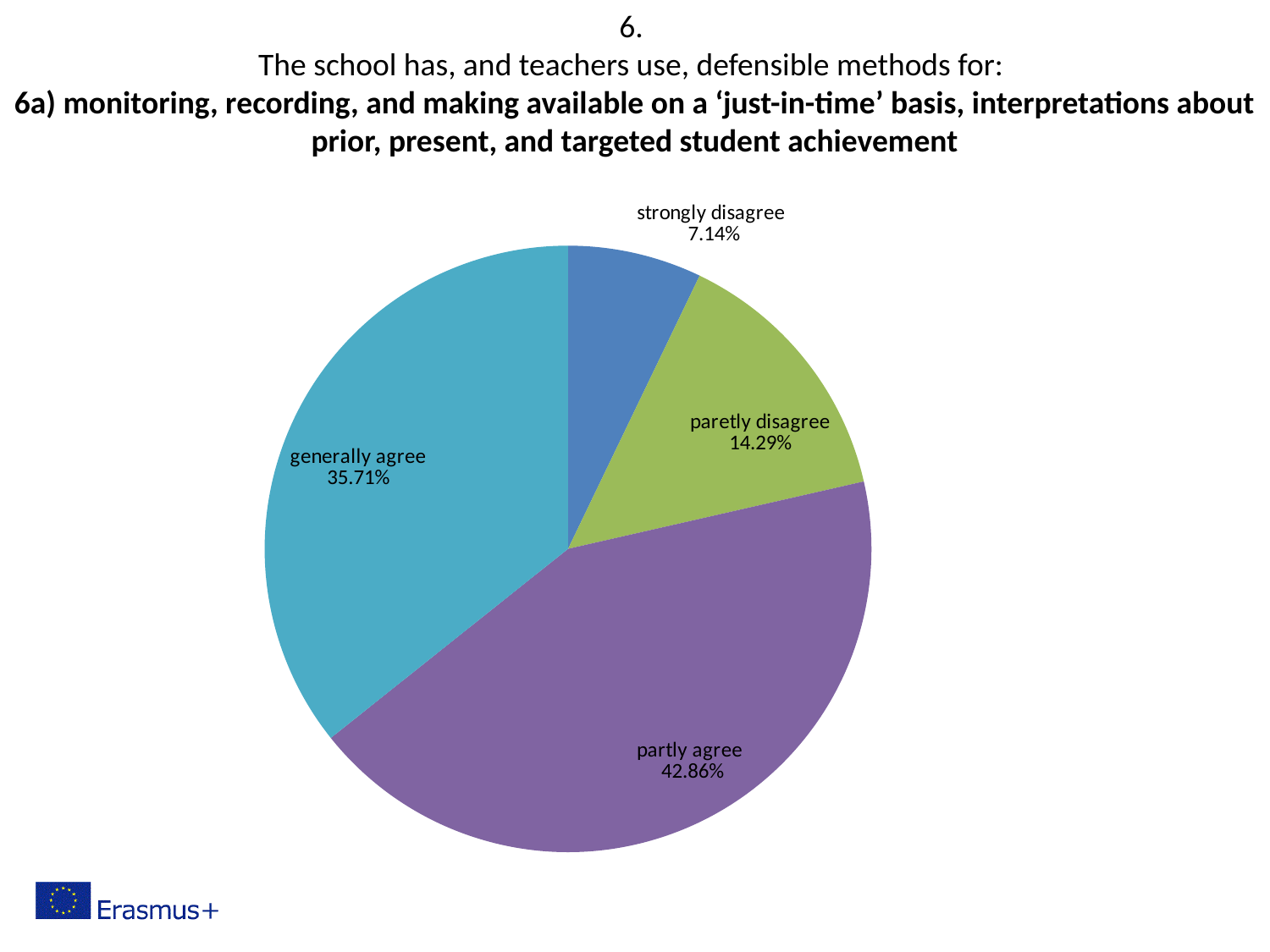
What percentage of respondents chose 'strongly disagree'? 7.14% How many slices does the pie chart have? 4 What colour is the 'partly agree' slice? purple Which response category has the largest share of the pie? partly agree Which response category has the smallest share of the pie? strongly disagree What percentage of respondents chose 'partly agree'? 42.86% What is the combined share of 'partly agree' and 'generally agree'? 78.57% What percentage of respondents chose 'paretly disagree'? 14.29% What is the difference in percentage points between 'partly agree' and 'generally agree'? 7.15 Which is larger, the share for 'paretly disagree' or the share for 'strongly disagree'? paretly disagree What kind of chart is shown on the slide? pie chart What percentage of respondents chose 'generally agree'? 35.71%